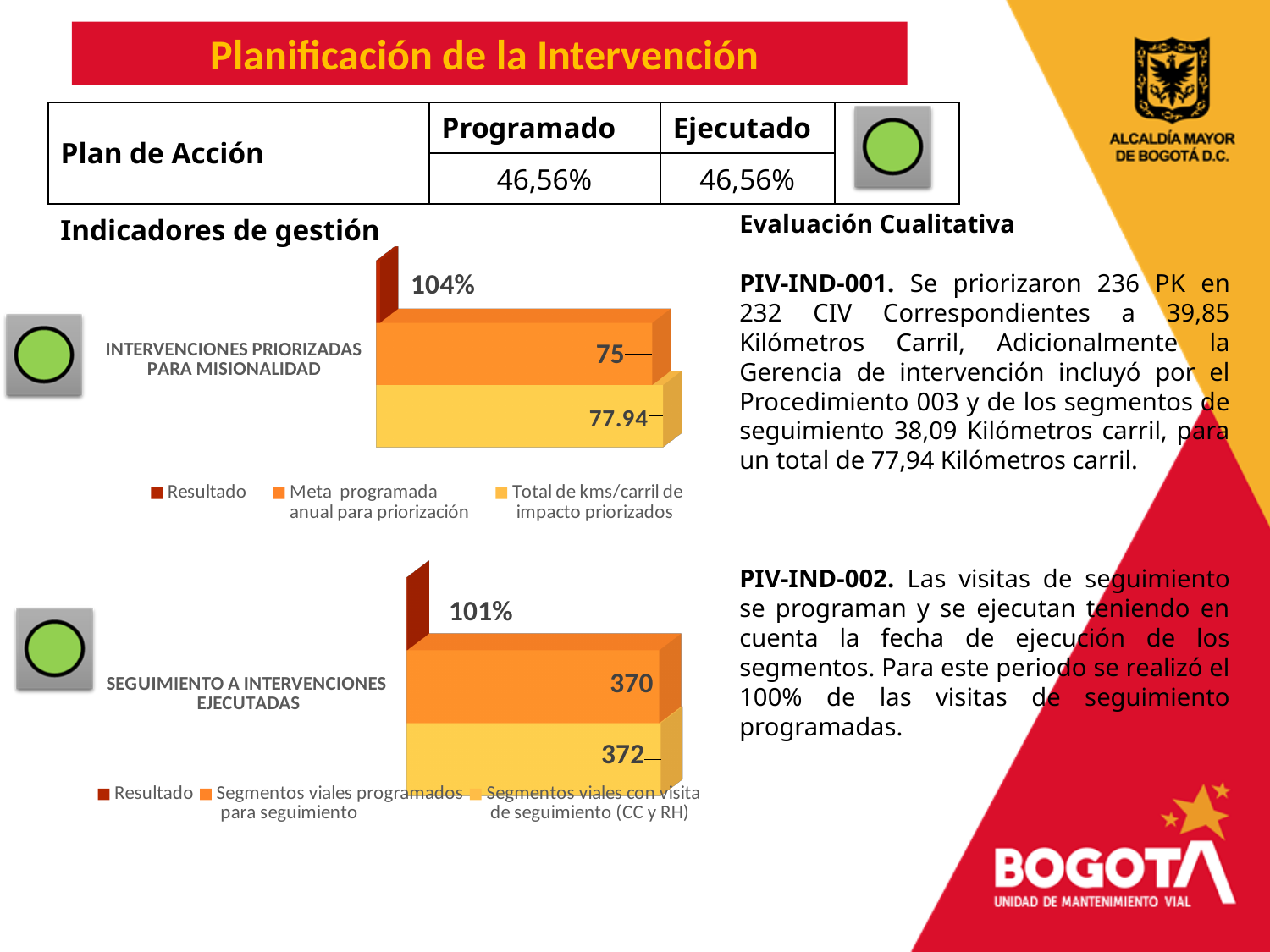
In the INTERVENCIONES PRIORIZADAS PARA MISIONALIDAD chart, which is larger: Meta programada anual para priorización or Total de kms/carril de impacto priorizados? Total de kms/carril de impacto priorizados In the SEGUIMIENTO A INTERVENCIONES EJECUTADAS chart, what is the difference between Segmentos viales con visita de seguimiento (CC y RH) and Segmentos viales programados para seguimiento? 2 In the INTERVENCIONES PRIORIZADAS PARA MISIONALIDAD chart, what is the value for Total de kms/carril de impacto priorizados? 77.94 In the INTERVENCIONES PRIORIZADAS PARA MISIONALIDAD chart, what value is shown for Resultado? 104% In the SEGUIMIENTO A INTERVENCIONES EJECUTADAS chart, what colour is the Resultado series in the legend? Dark red What kind of chart is the SEGUIMIENTO A INTERVENCIONES EJECUTADAS chart? Bar chart In the SEGUIMIENTO A INTERVENCIONES EJECUTADAS chart, what is the value for Segmentos viales con visita de seguimiento (CC y RH)? 372 In the INTERVENCIONES PRIORIZADAS PARA MISIONALIDAD chart, how many series does the legend list? 3 In the INTERVENCIONES PRIORIZADAS PARA MISIONALIDAD chart, what is the difference between Total de kms/carril de impacto priorizados and Meta programada anual para priorización? 2.94 In the INTERVENCIONES PRIORIZADAS PARA MISIONALIDAD chart, what is the value for Meta programada anual para priorización? 75 In the SEGUIMIENTO A INTERVENCIONES EJECUTADAS chart, what is the value for Segmentos viales programados para seguimiento? 370 In the SEGUIMIENTO A INTERVENCIONES EJECUTADAS chart, what value is shown for Resultado? 101%